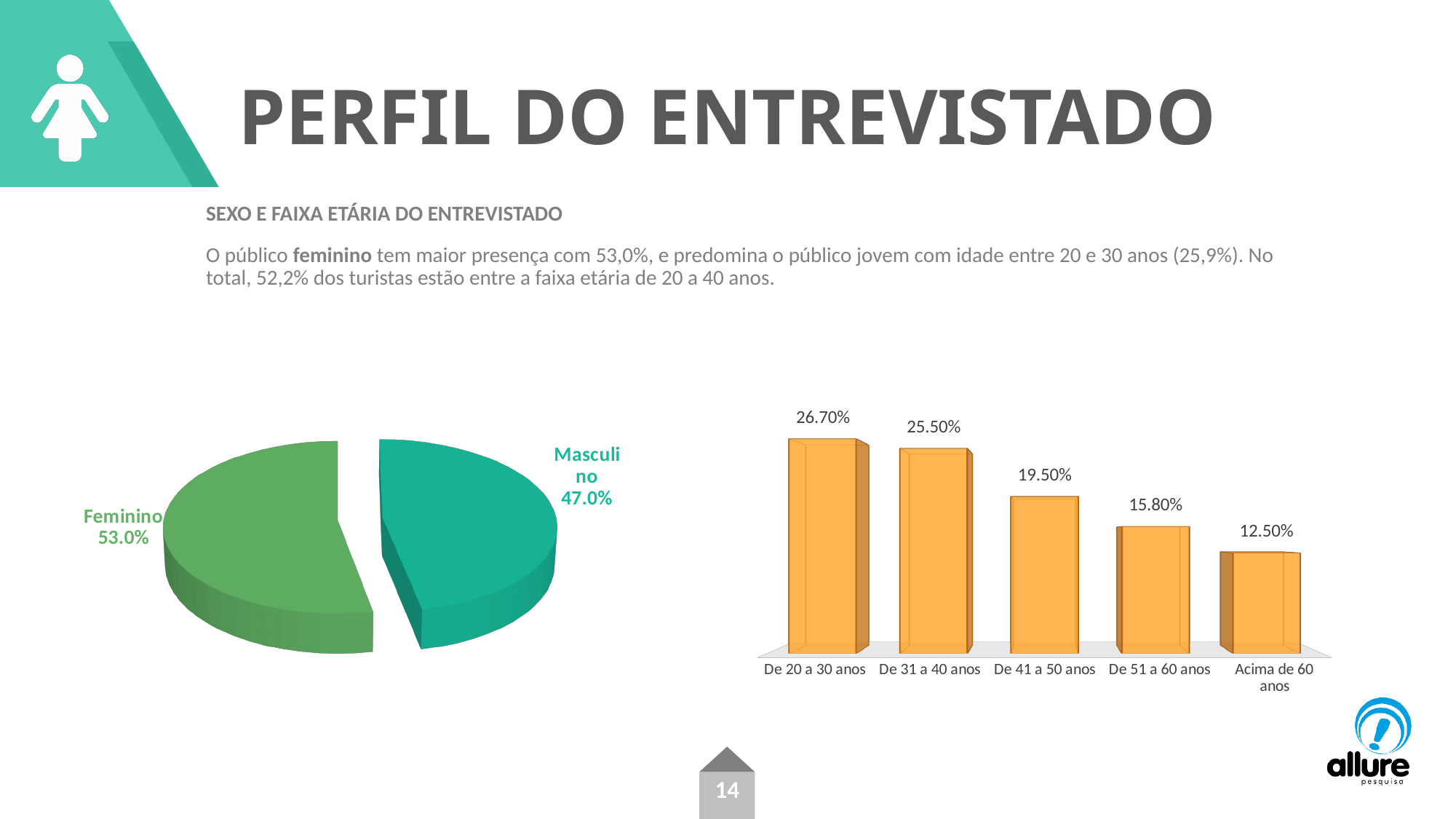
In the pie chart on the left, what share is labelled for Masculino? 47.0% In the bar chart on the right, what is the value for Acima de 60 anos? 12.50% In the pie chart on the left, which slice is larger, Feminino or Masculino? Feminino In the bar chart on the right, which age group has the highest value? De 20 a 30 anos In the pie chart on the left, what share is labelled for Feminino? 53.0% In the bar chart on the right, how many age groups are shown? 5 What kind of chart is the chart on the left of the slide? Pie chart In the bar chart on the right, what is the value for De 20 a 30 anos? 26.70% In the bar chart on the right, what is the difference between De 41 a 50 anos and De 51 a 60 anos? 3.70% In the pie chart on the left, how many slices are there? 2 In the bar chart on the right, do the values rise or fall from left to right along the x axis? Fall In the bar chart on the right, which age group has the lowest value? Acima de 60 anos